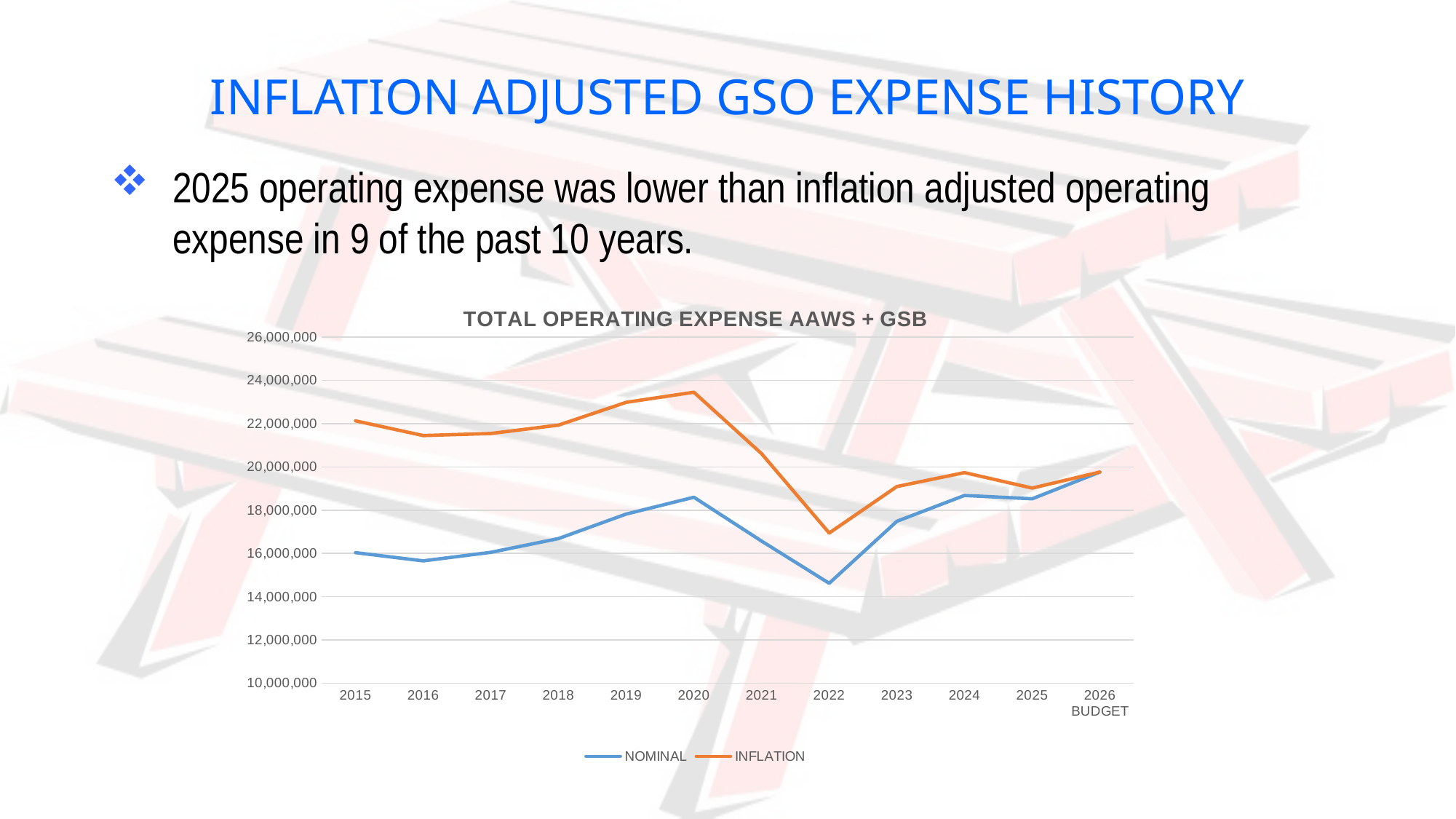
In which year does the NOMINAL series reach its lowest value? 2022 What is the title of the chart? TOTAL OPERATING EXPENSE AAWS + GSB Does the NOMINAL series rise or fall from 2022 to 2023? rise How many series does the legend list? 2 Is the INFLATION value for 2020 greater or less than 22,000,000? greater Which series has the larger value in 2019, NOMINAL or INFLATION? INFLATION In which year does the INFLATION series reach its lowest value? 2022 What kind of chart is shown on the slide? line chart In which year does the INFLATION series reach its highest value? 2020 How many points are plotted along the x axis? 12 Which series is drawn in orange? INFLATION Is the NOMINAL value for 2022 greater or less than 16,000,000? less